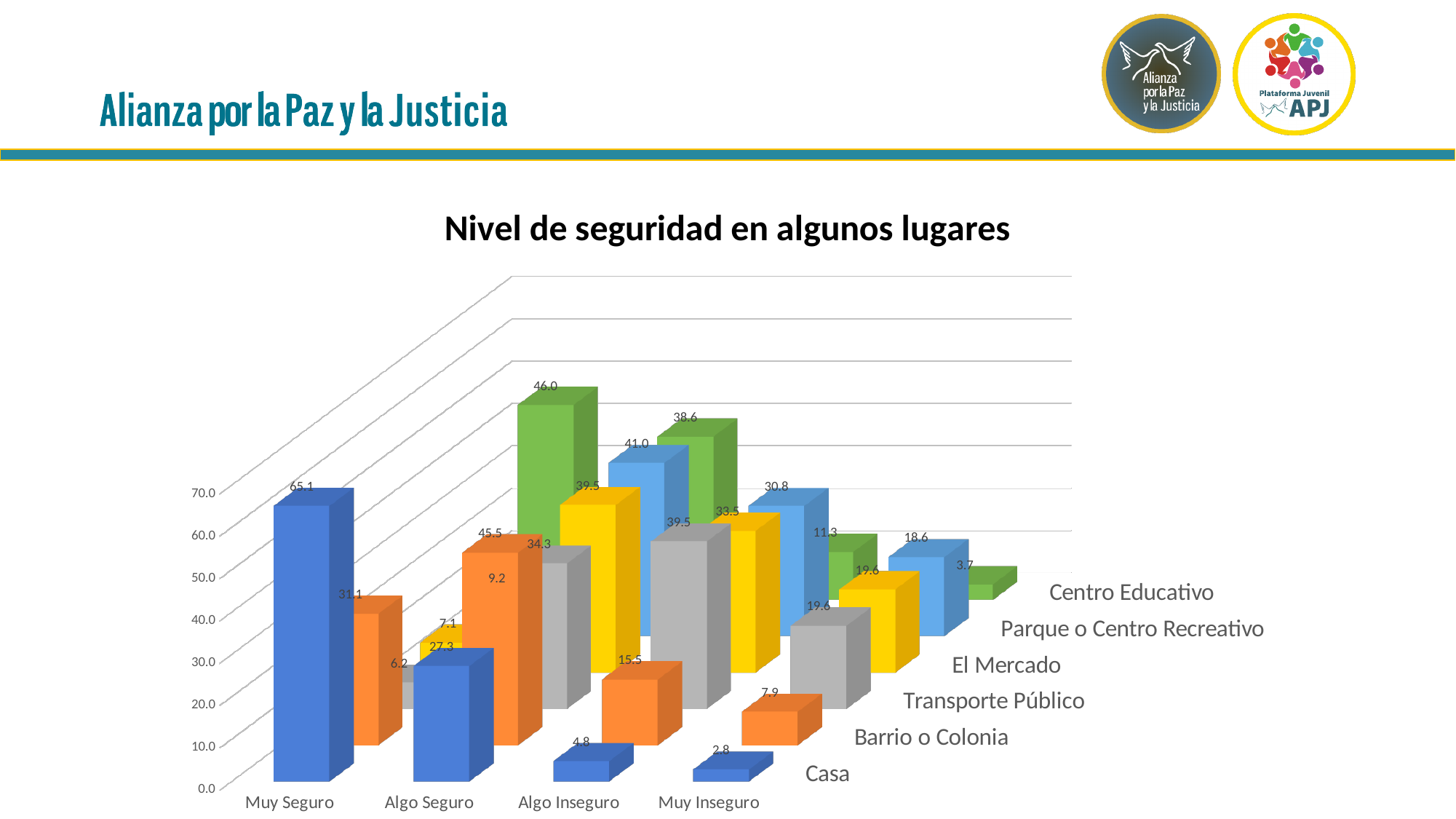
What is the title of the chart? Nivel de seguridad en algunos lugares How many security-level categories are shown along the x axis? 4 Which place has the highest value under Muy Seguro? Casa What is the value for Barrio o Colonia under Algo Seguro? 45.5 Which security level has the lowest value for Casa? Muy Inseguro What is the value for Casa under Muy Inseguro? 2.8 What is the difference between the Casa values for Muy Seguro and Algo Seguro? 37.8 What kind of chart is shown on the slide? 3D bar chart How many places (series) are plotted in the chart? 6 What is the value for Centro Educativo under Muy Inseguro? 3.7 What is the value for Casa under Muy Seguro? 65.1 Do the values for Casa rise or fall from Muy Seguro to Muy Inseguro? fall